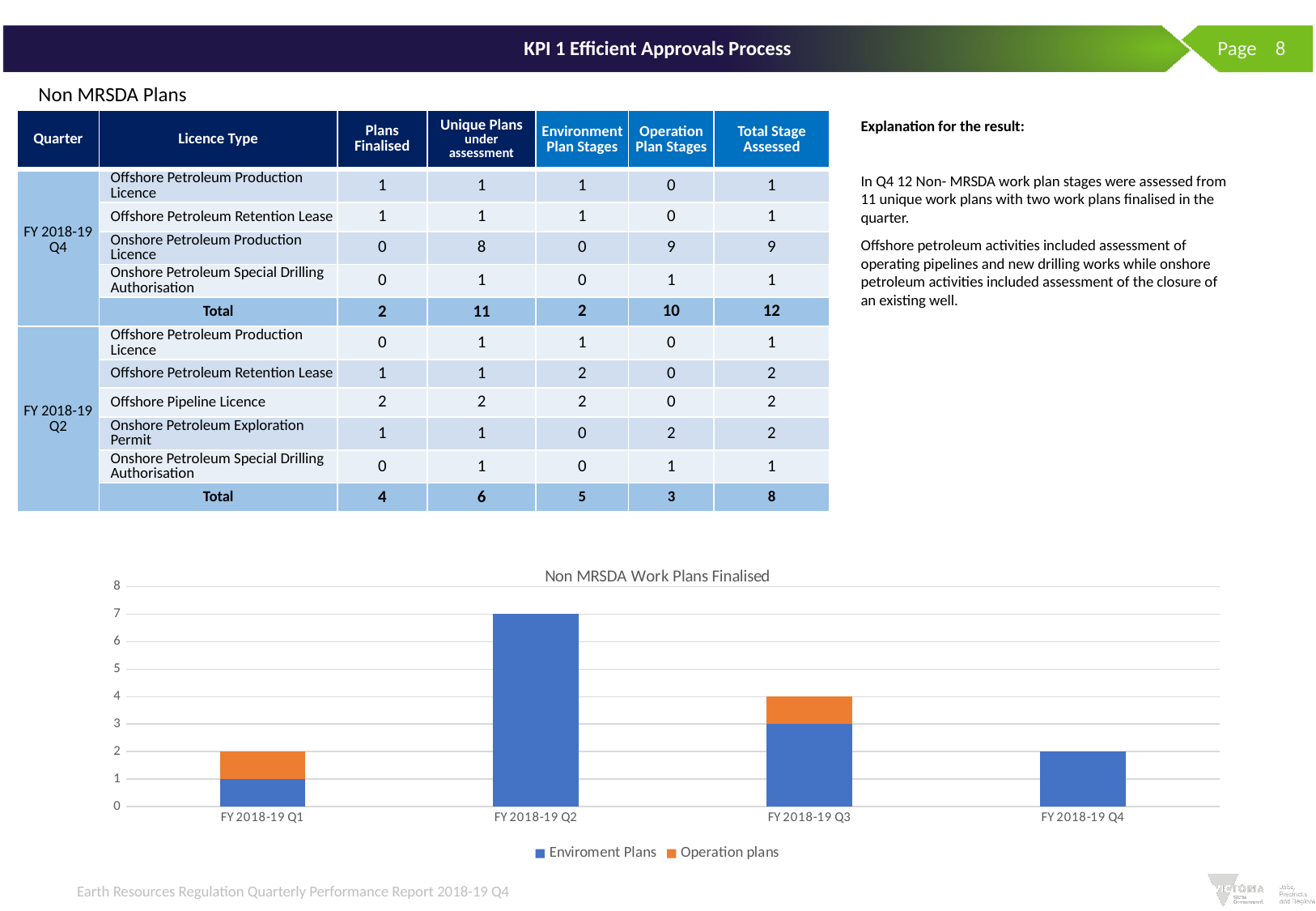
Which is larger: the Environment Plans value for FY 2018-19 Q3 or for FY 2018-19 Q4? FY 2018-19 Q3 How many series does the chart legend list? 2 How many quarters are shown on the x axis of the chart? 4 What is the value for Environment Plans in FY 2018-19 Q2? 7 Is the value for Environment Plans in FY 2018-19 Q2 greater or less than 5? greater Which colour represents Operation plans in the chart? orange What kind of chart is shown at the bottom of the slide? bar chart What is the value for Environment Plans in FY 2018-19 Q4? 2 What is the total height of the stacked bar for FY 2018-19 Q3? 4 Which quarter has the tallest bar in the chart? FY 2018-19 Q2 Which quarter has the lowest value for Environment Plans? FY 2018-19 Q1 What is the title of the chart? Non MRSDA Work Plans Finalised